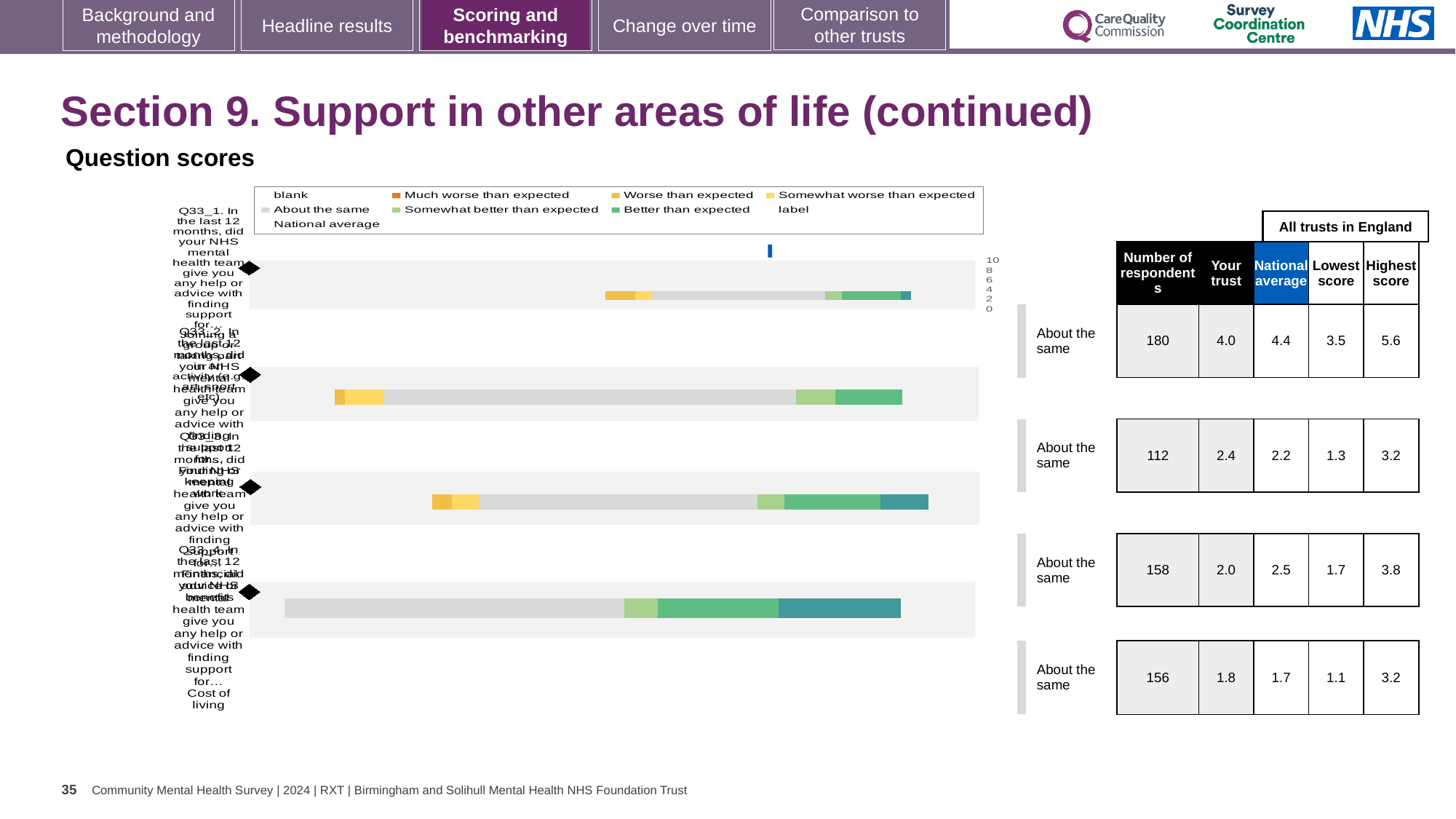
How many entries does the chart legend list? 9 How many question bars are plotted in the chart? 4 Which question row has the highest number of respondents in the table? the first (top) row, 180 For the third question row, which is larger: the 'Your trust' score or the national average? National average In the table, what is the lowest score for the fourth (bottom) question row? 1.1 What is the difference between the national average and the 'Your trust' score for the first (top) question row? 0.4 In the table, what is the highest score for the third question row? 3.8 In the table, what is the number of respondents for the first (top) question row? 180 What benchmark label is shown next to each of the four question bars? About the same What kind of chart is used to show the question scores on this slide? bar chart In the table, what is the 'Your trust' score for the first (top) question row? 4.0 In the table, what is the national average for the second question row? 2.2